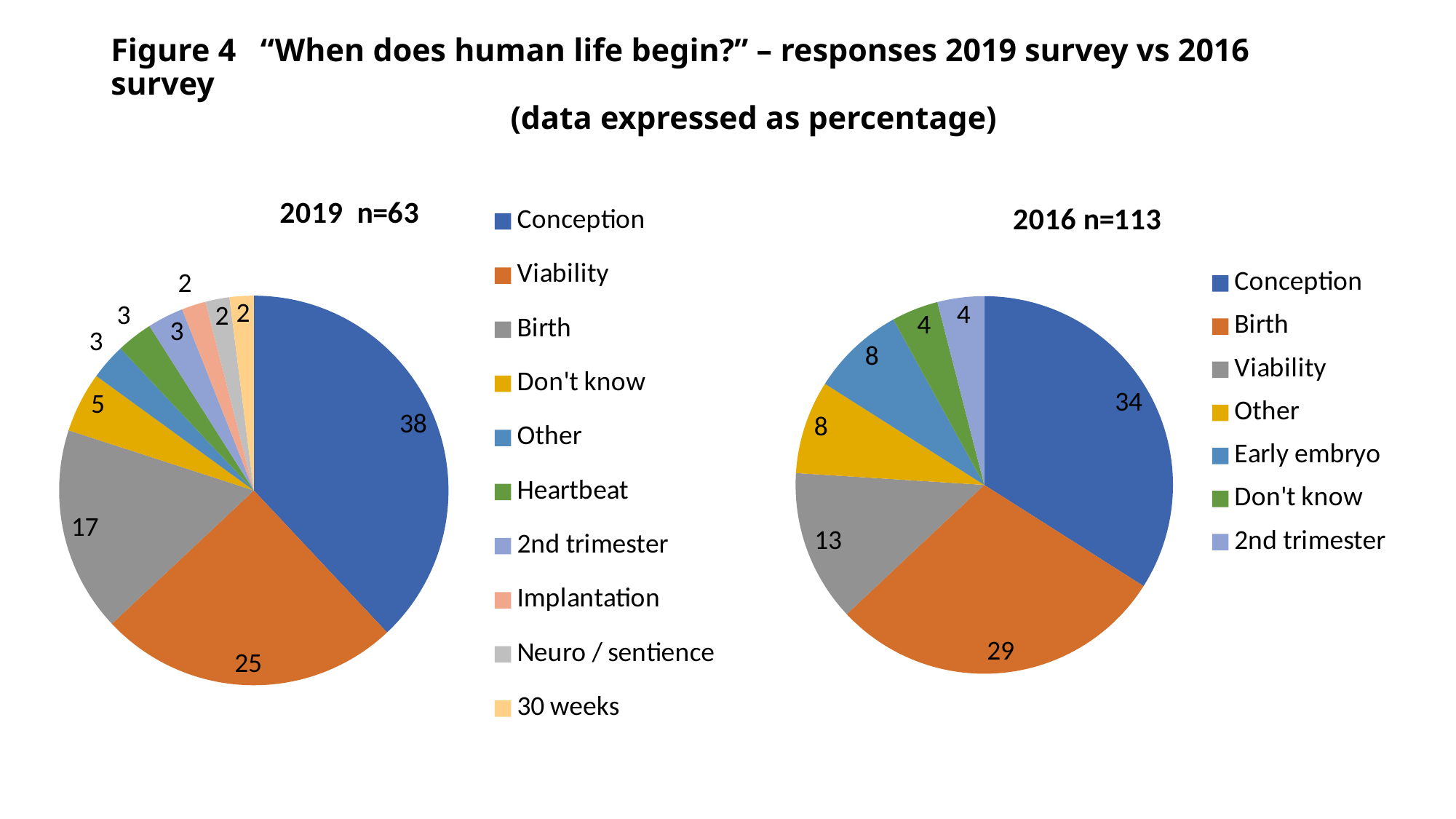
In the 2019 n=63 chart, which category has the largest share? Conception How many categories does the legend of the 2019 n=63 chart list? 10 In the 2016 n=113 chart, which category has the largest share? Conception In the 2016 n=113 chart, what is the difference between the Birth and Viability percentages? 16 How many categories does the legend of the 2016 n=113 chart list? 7 In the 2019 n=63 chart, what percentage of responses was Viability? 25 In the 2016 n=113 chart, what percentage of responses was Viability? 13 In the 2016 n=113 chart, what percentage of responses was Birth? 29 In the 2019 n=63 chart, what percentage of responses was Conception? 38 In the 2019 n=63 chart, what is the difference between the Conception and Viability percentages? 13 Which is larger in the 2016 n=113 chart: Other or Don't know? Other What type of charts are shown on the slide? Pie charts